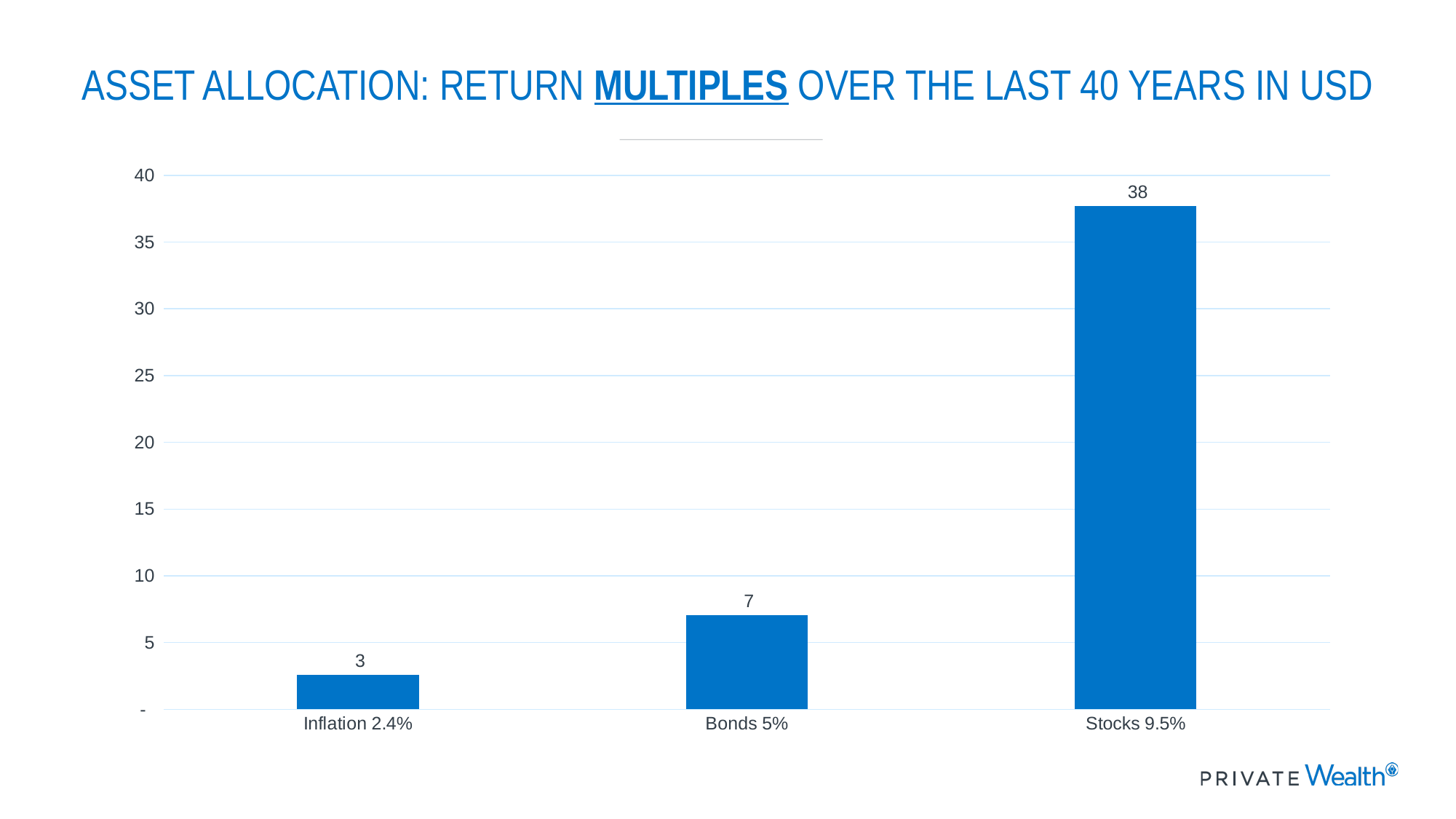
What is the return multiple shown for Bonds 5%? 7 What kind of chart is shown on the slide? Bar chart What is the difference between the return multiples for Bonds 5% and Inflation 2.4%? 4 What is the return multiple shown for Stocks 9.5%? 38 Which category has the lowest return multiple? Inflation 2.4% Is the value for Stocks 9.5% greater or less than 35? greater Do the values rise or fall moving from left to right along the x axis? Rise Which category has the highest return multiple? Stocks 9.5% How many categories are shown on the chart? 3 What is the return multiple shown for Inflation 2.4%? 3 Which is larger, the return multiple for Bonds 5% or for Inflation 2.4%? Bonds 5% What is the difference between the return multiples for Stocks 9.5% and Bonds 5%? 31